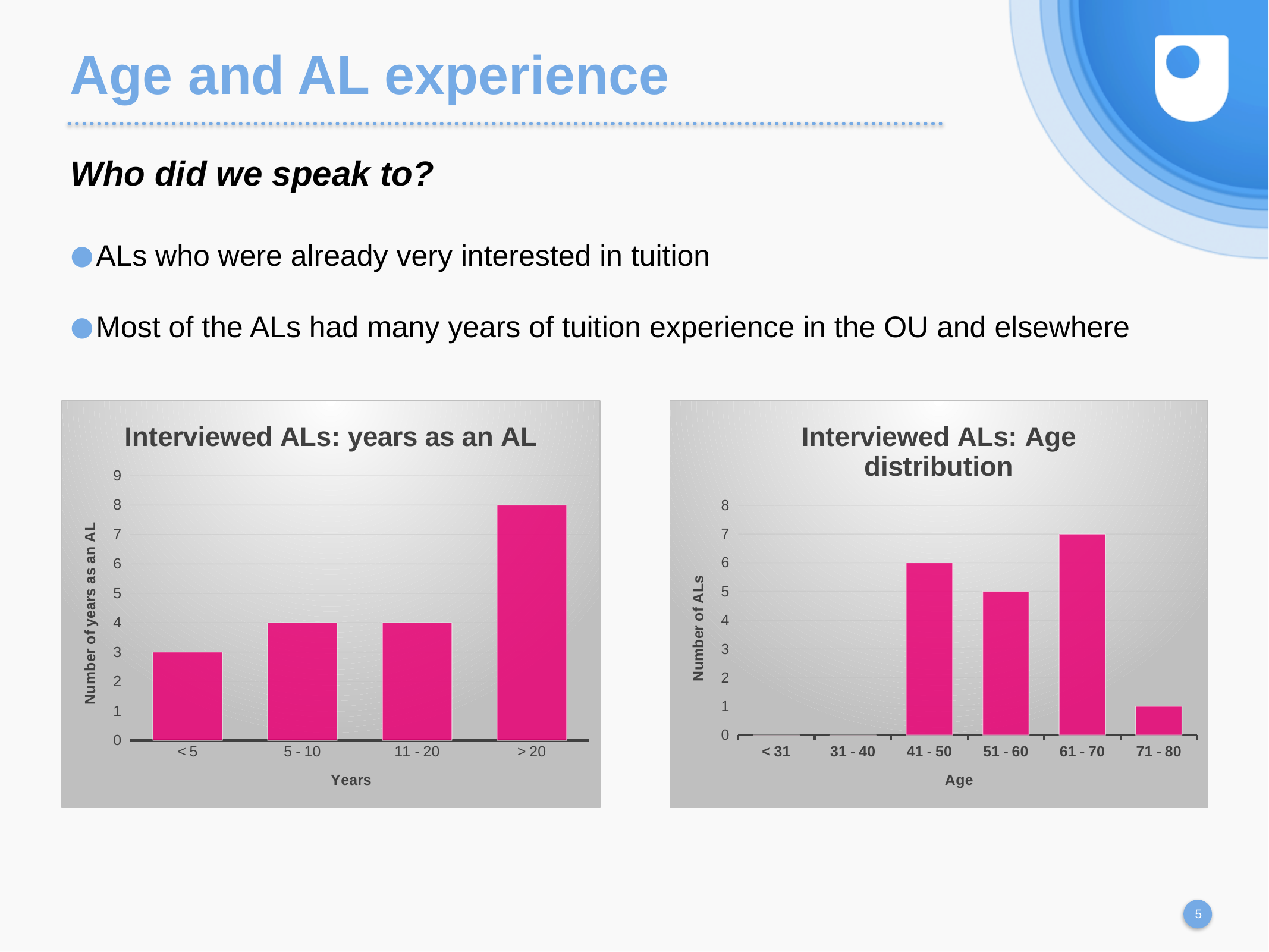
In the 'Interviewed ALs: years as an AL' chart, what is the difference between the '> 20' and '< 5' values? 5 In the 'Interviewed ALs: Age distribution' chart, what is the value for the '61 - 70' category? 7 In the 'Interviewed ALs: years as an AL' chart, what is the value for the '< 5' category? 3 In the 'Interviewed ALs: years as an AL' chart, which category has the lowest value? < 5 In the 'Interviewed ALs: years as an AL' chart, which category has the highest value? > 20 In the 'Interviewed ALs: years as an AL' chart, how many categories are shown on the x axis? 4 In the 'Interviewed ALs: Age distribution' chart, how many age categories are shown on the x axis? 6 In the 'Interviewed ALs: Age distribution' chart, what is the value for the '41 - 50' category? 6 In the 'Interviewed ALs: Age distribution' chart, which is larger, the value for '51 - 60' or the value for '71 - 80'? 51 - 60 In the 'Interviewed ALs: years as an AL' chart, what is the value for the '> 20' category? 8 What kind of chart is the 'Interviewed ALs: Age distribution' chart? Bar chart In the 'Interviewed ALs: Age distribution' chart, which age category has the highest value? 61 - 70